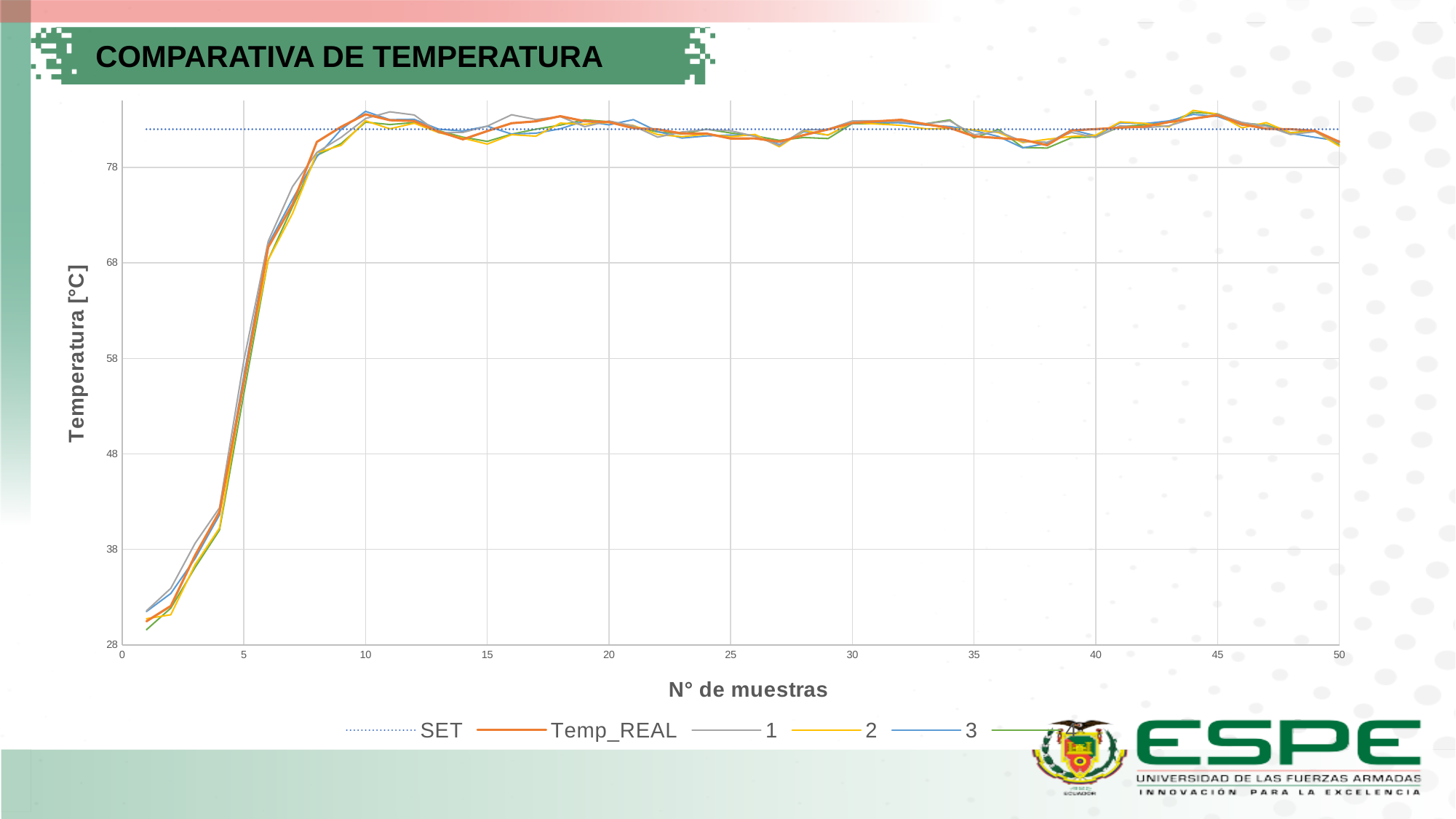
Is the value of Temp_REAL at sample 30 greater or less than 68? greater What is the title of the chart? COMPARATIVA DE TEMPERATURA What kind of chart is shown on the slide? line chart What is the label of the x axis? N° de muestras Is the SET line greater or less than 78? greater Do the temperature values rise or fall between sample 1 and sample 10? rise Which series is drawn as a dotted line? SET Is the value of Temp_REAL at sample 1 greater or less than 38? less What is the highest sample number shown on the x axis? 50 How many series does the legend list? 6